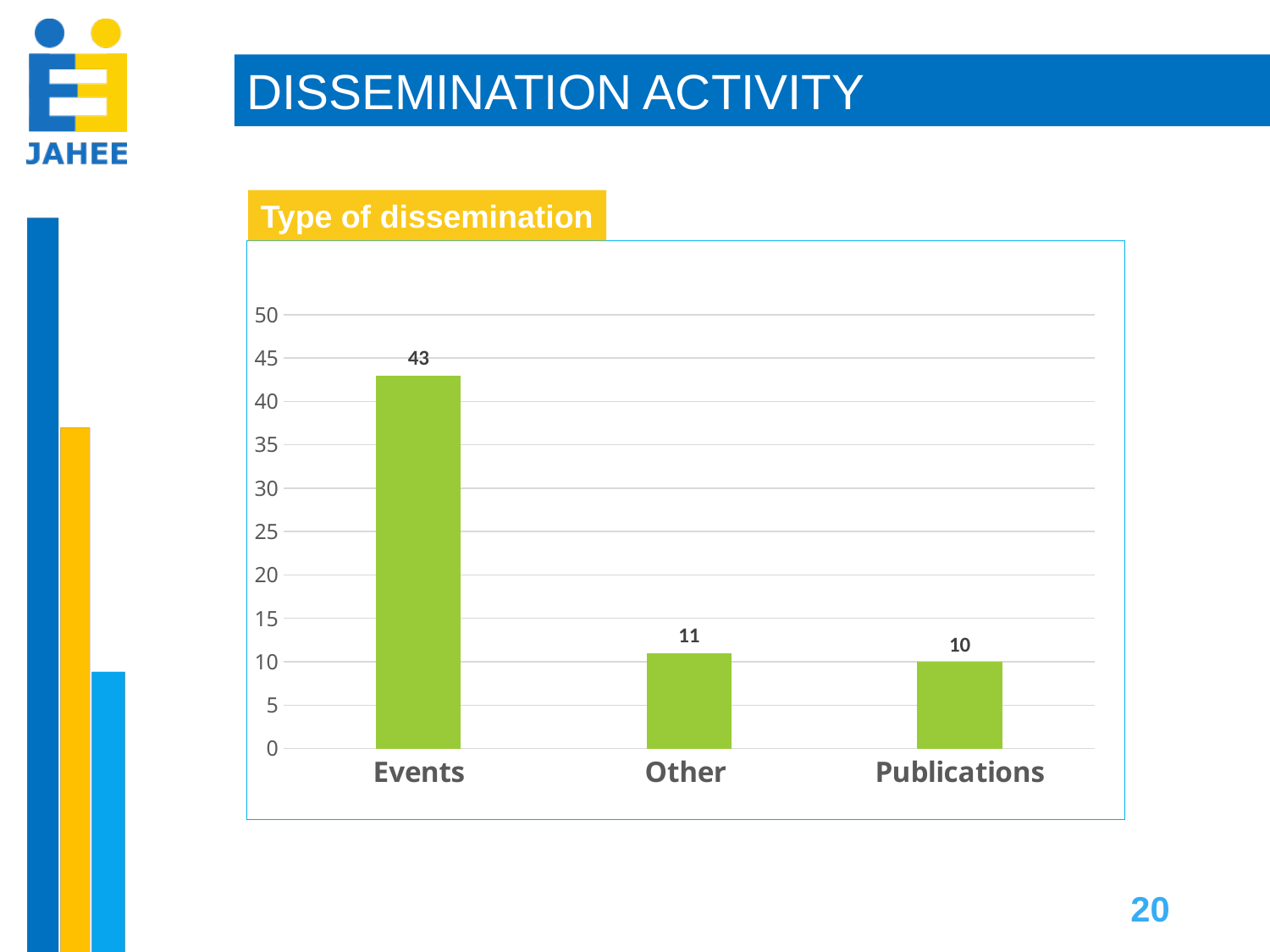
Is the value for Events greater or less than 40? greater What is the difference between the values for Other and Publications? 1 What is the value for Events? 43 What is the difference between the values for Events and Other? 32 How many categories are shown in the chart? 3 What kind of chart is shown on the slide? bar chart Which category has the lowest value? Publications Which category has the highest value? Events What is the title of the chart? Type of dissemination What is the value for Publications? 10 What is the value for Other? 11 Which is larger, the value for Events or the value for Publications? Events